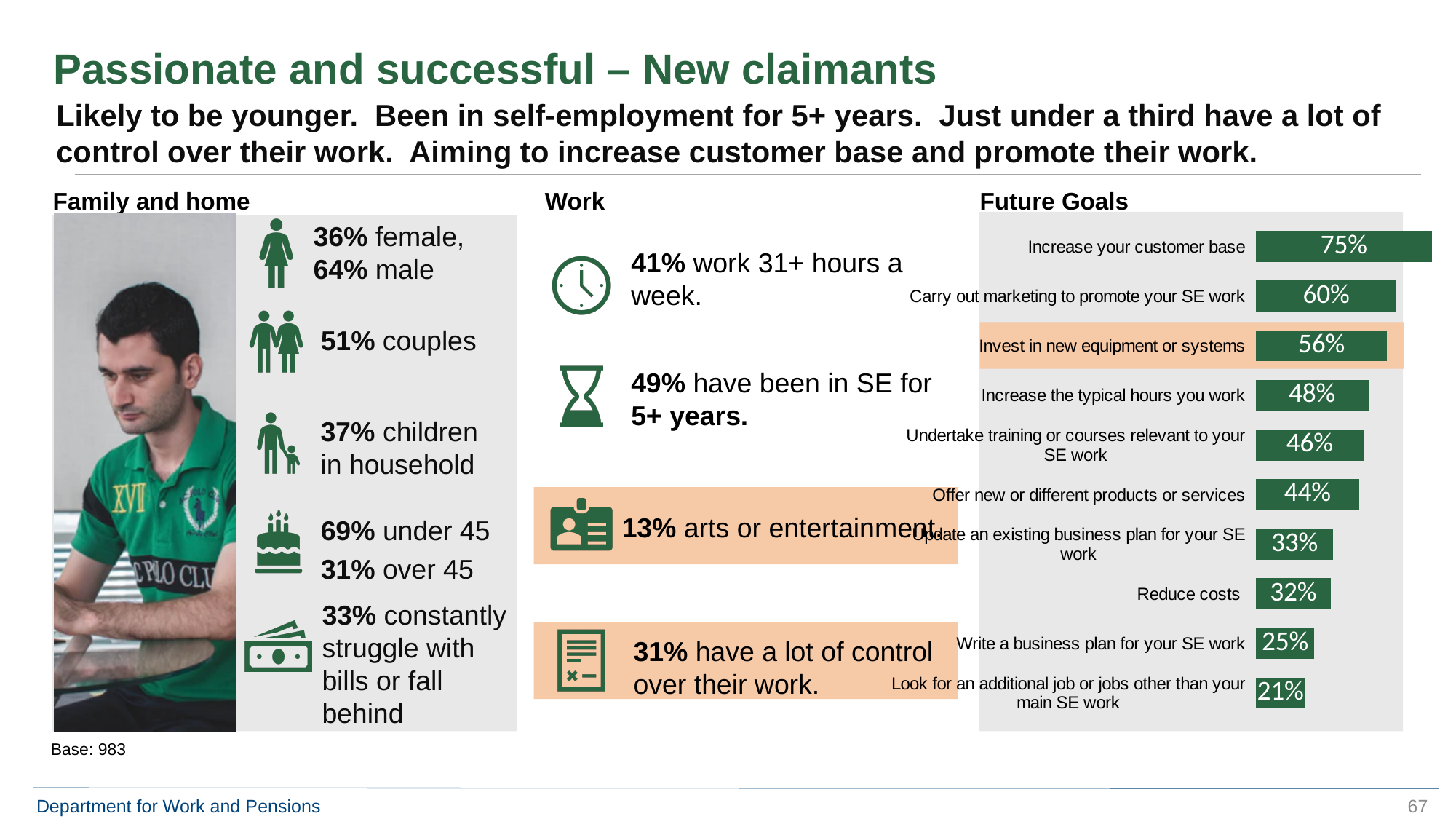
In the Future Goals chart, which goal has the lowest value? Look for an additional job or jobs other than your main SE work In the Future Goals chart, what percentage of new claimants aim to increase their customer base? 75% In the Future Goals chart, do the values increase or decrease going from the top bar to the bottom bar? Decrease In the Future Goals chart, what is the difference between 'Increase your customer base' and 'Carry out marketing to promote your SE work'? 15% What kind of chart is the Future Goals chart? Bar chart In the Future Goals chart, which goal has the highest value? Increase your customer base In the Future Goals chart, what is the difference between 'Invest in new equipment or systems' and 'Write a business plan for your SE work'? 31% In the Future Goals chart, what is the value for 'Carry out marketing to promote your SE work'? 60% How many goals are shown in the Future Goals chart? 10 In the Future Goals chart, which is larger: 'Increase the typical hours you work' or 'Offer new or different products or services'? Increase the typical hours you work In the Future Goals chart, what is the value for 'Look for an additional job or jobs other than your main SE work'? 21% In the Future Goals chart, what is the value for 'Reduce costs'? 32%